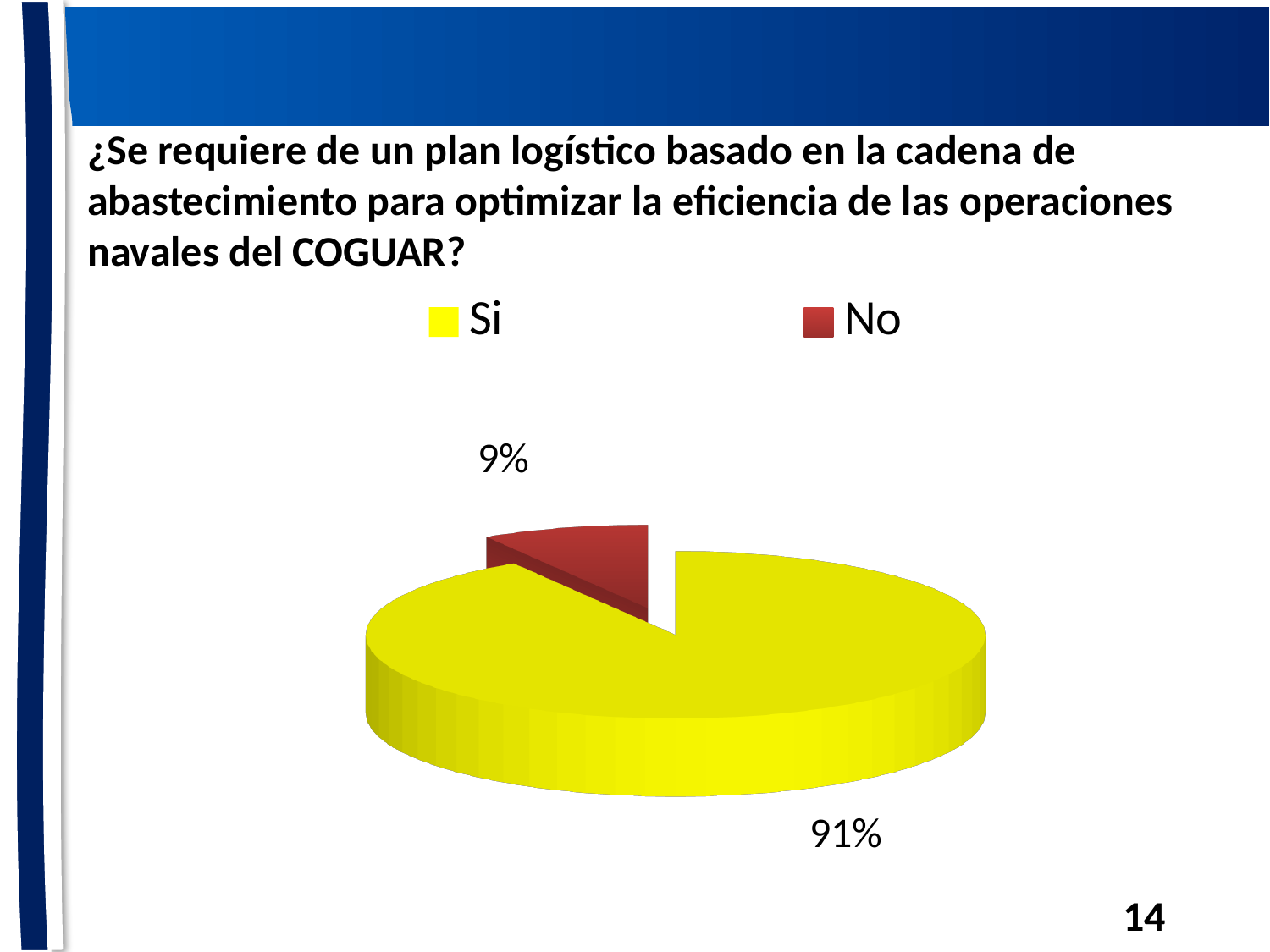
What is the difference in percentage points between the "Si" and "No" slices? 82 Which category has the largest slice of the pie? Si What share of the pie does the "No" slice represent? 9% What colour is the "No" slice in the pie chart? red Which category has the smallest slice of the pie? No How many entries does the legend list? 2 Which is larger, the "Si" slice or the "No" slice? Si How many categories does the pie chart have? 2 What kind of chart is shown on the slide? pie chart What share of the pie does the "Si" slice represent? 91% What colour is the "Si" slice in the pie chart? yellow